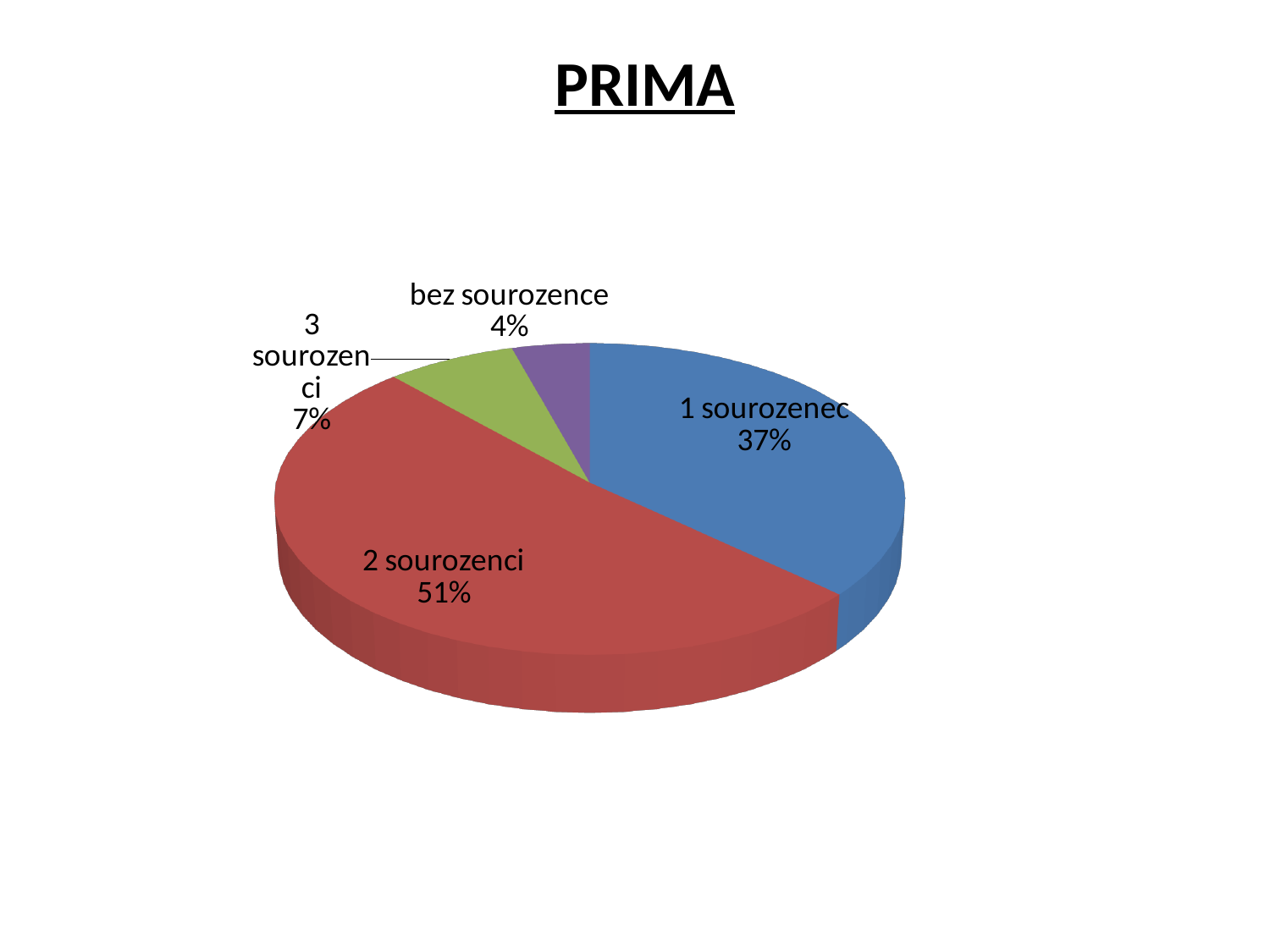
What share of the pie does "3 sourozenci" have? 7% What share of the pie does "1 sourozenec" have? 37% Which category has the largest slice of the pie? 2 sourozenci Which category has the smallest slice of the pie? bez sourozence Which is larger, the share for "3 sourozenci" or the share for "bez sourozence"? 3 sourozenci What kind of chart is shown on the slide? pie chart What colour is the slice for "2 sourozenci"? red What is the difference in percentage points between "2 sourozenci" and "1 sourozenec"? 14 How many slices does the pie chart have? 4 What share of the pie does "2 sourozenci" have? 51% What is the title shown above the chart? PRIMA